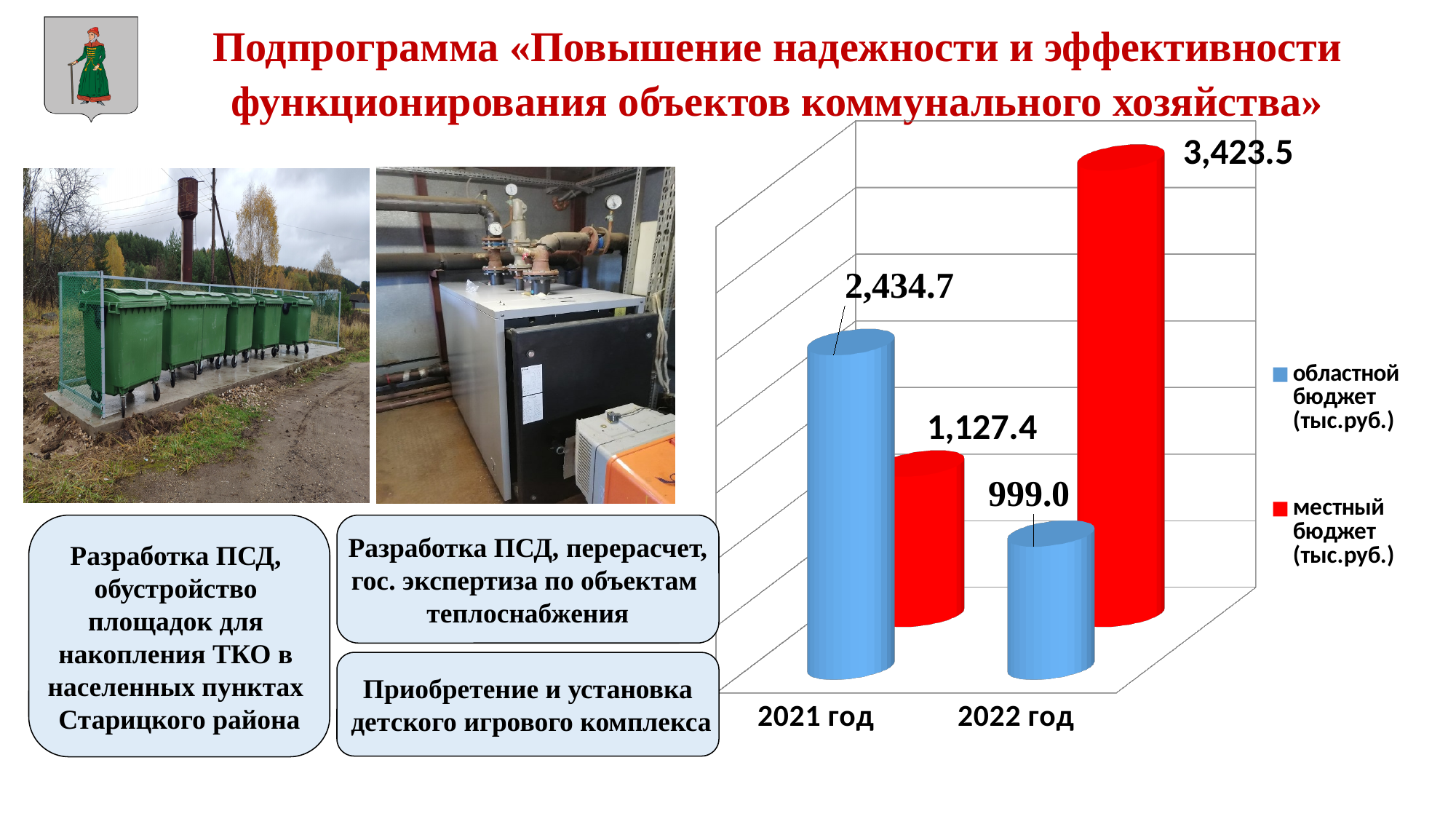
How many series does the legend list? 2 Which is larger in 2022 год: областной бюджет or местный бюджет? местный бюджет Which bar has the lowest value on the chart? областной бюджет, 2022 год How many categories are shown on the x axis? 2 Does the value of областной бюджет rise or fall from 2021 год to 2022 год? fall What is the value of областной бюджет (тыс.руб.) for 2022 год? 999.0 What is the value of областной бюджет (тыс.руб.) for 2021 год? 2,434.7 What is the value of местный бюджет (тыс.руб.) for 2022 год? 3,423.5 What is the difference between местный бюджет and областной бюджет in 2022 год? 2,424.5 What is the value of местный бюджет (тыс.руб.) for 2021 год? 1,127.4 What is the difference between областной бюджет and местный бюджет in 2021 год? 1,307.3 Which bar has the highest value on the chart? местный бюджет, 2022 год